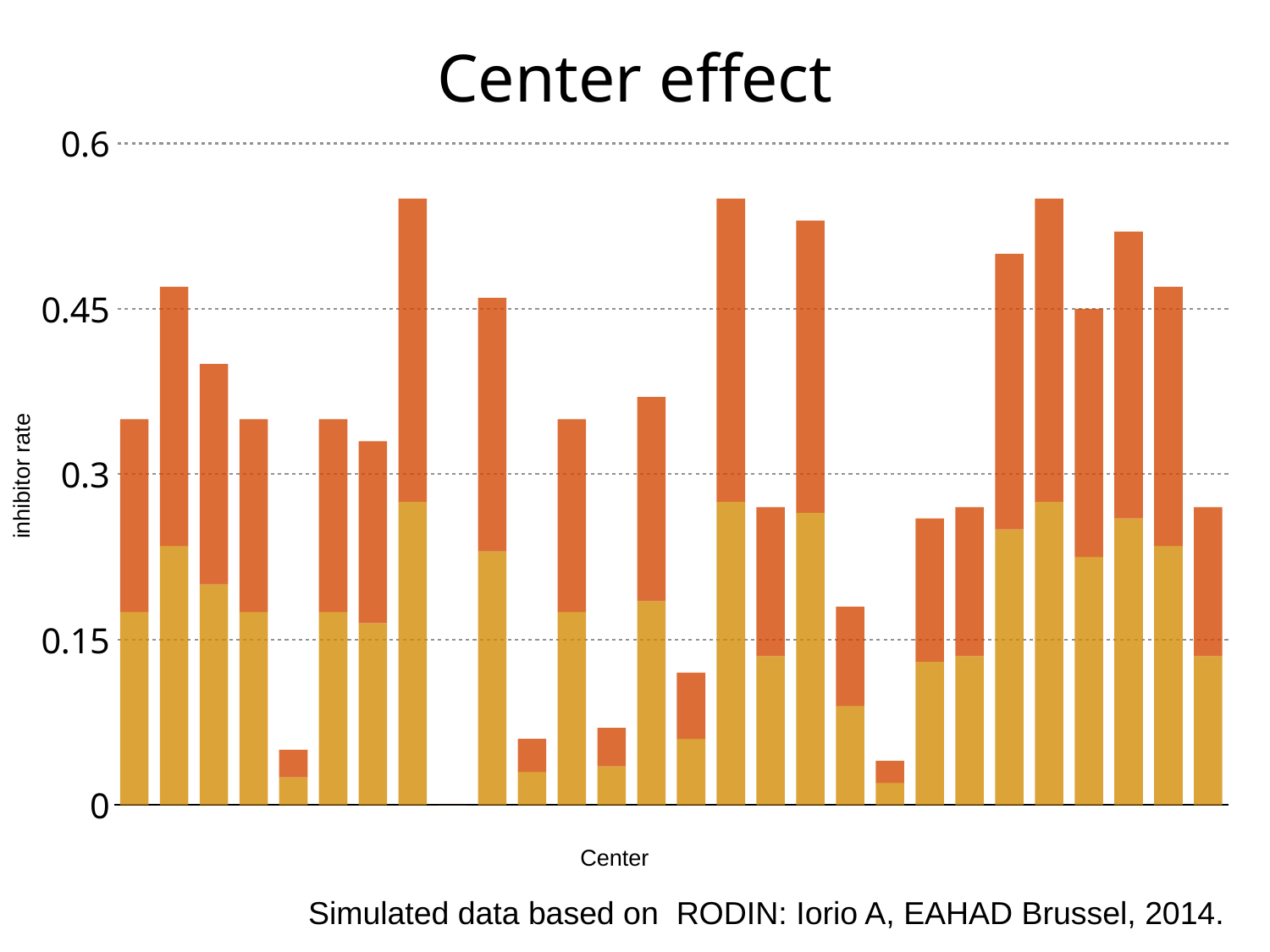
Is the value for the fifth bar from the left greater or less than 0.15? less Is the value for the first bar from the left greater or less than 0.3? greater How many stacked segments does each bar have? 2 What kind of chart is shown on the slide? Stacked bar chart What is the title of the chart? Center effect Which is larger, the first bar from the left or the second bar from the left? The second bar Is the value for the shortest bar in the chart greater or less than 0.15? less What is the label on the vertical axis of the chart? inhibitor rate